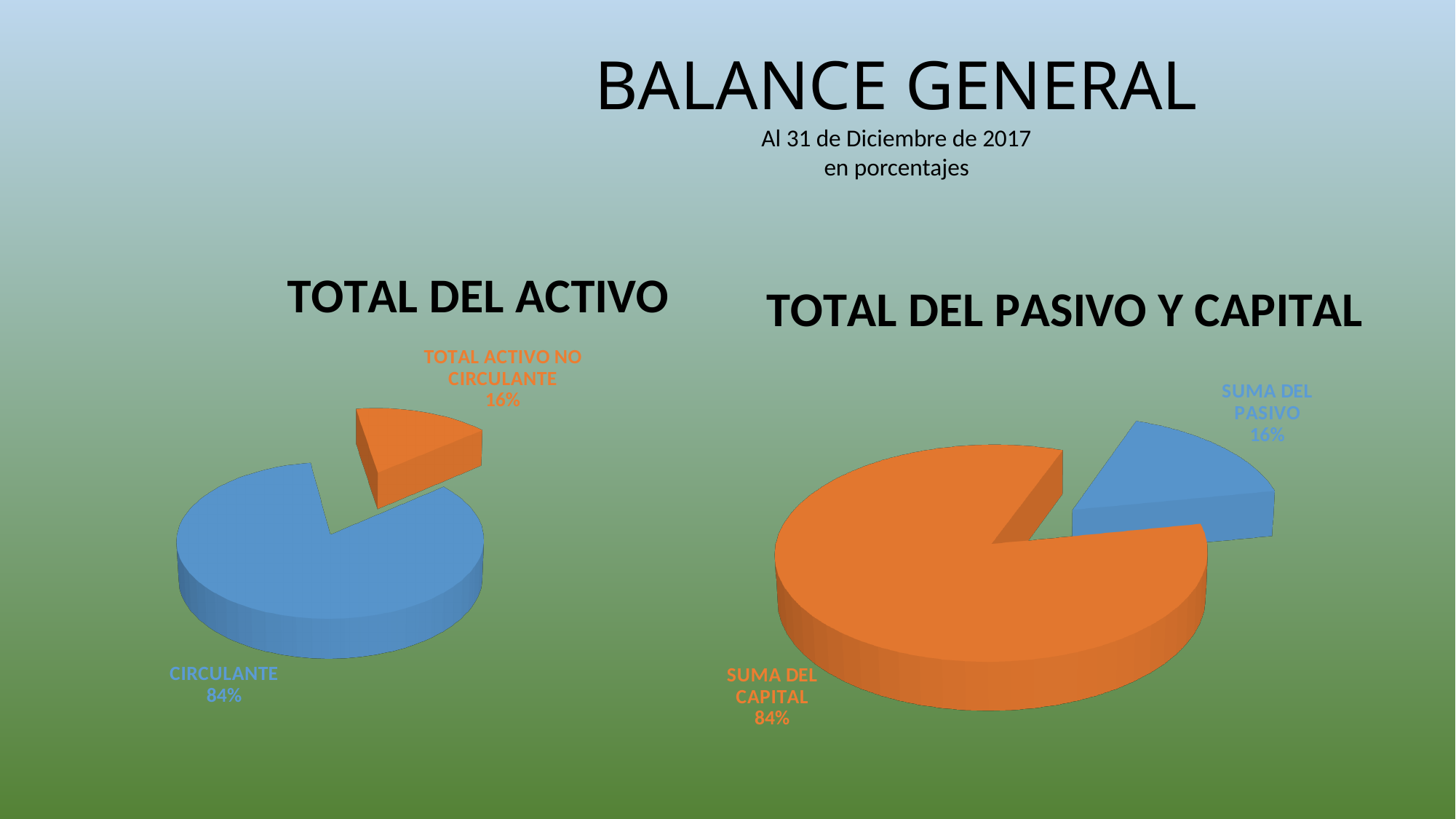
In the 'TOTAL DEL PASIVO Y CAPITAL' chart, what share does SUMA DEL CAPITAL have? 84% In the 'TOTAL DEL PASIVO Y CAPITAL' chart, which slice is the smallest? SUMA DEL PASIVO In the 'TOTAL DEL PASIVO Y CAPITAL' chart, what share does SUMA DEL PASIVO have? 16% In the 'TOTAL DEL ACTIVO' chart, what share does TOTAL ACTIVO NO CIRCULANTE have? 16% In the 'TOTAL DEL ACTIVO' chart, what share does CIRCULANTE have? 84% In the 'TOTAL DEL ACTIVO' chart, which slice is the largest? CIRCULANTE In the 'TOTAL DEL ACTIVO' chart, what is the difference in percentage points between CIRCULANTE and TOTAL ACTIVO NO CIRCULANTE? 68 In the 'TOTAL DEL PASIVO Y CAPITAL' chart, which is larger, SUMA DEL PASIVO or SUMA DEL CAPITAL? SUMA DEL CAPITAL What kind of chart is the 'TOTAL DEL PASIVO Y CAPITAL' chart? Pie chart How many slices does the 'TOTAL DEL ACTIVO' chart have? 2 What is the title of the chart on the left side of the slide? TOTAL DEL ACTIVO What colour is the SUMA DEL CAPITAL slice in the 'TOTAL DEL PASIVO Y CAPITAL' chart? Orange